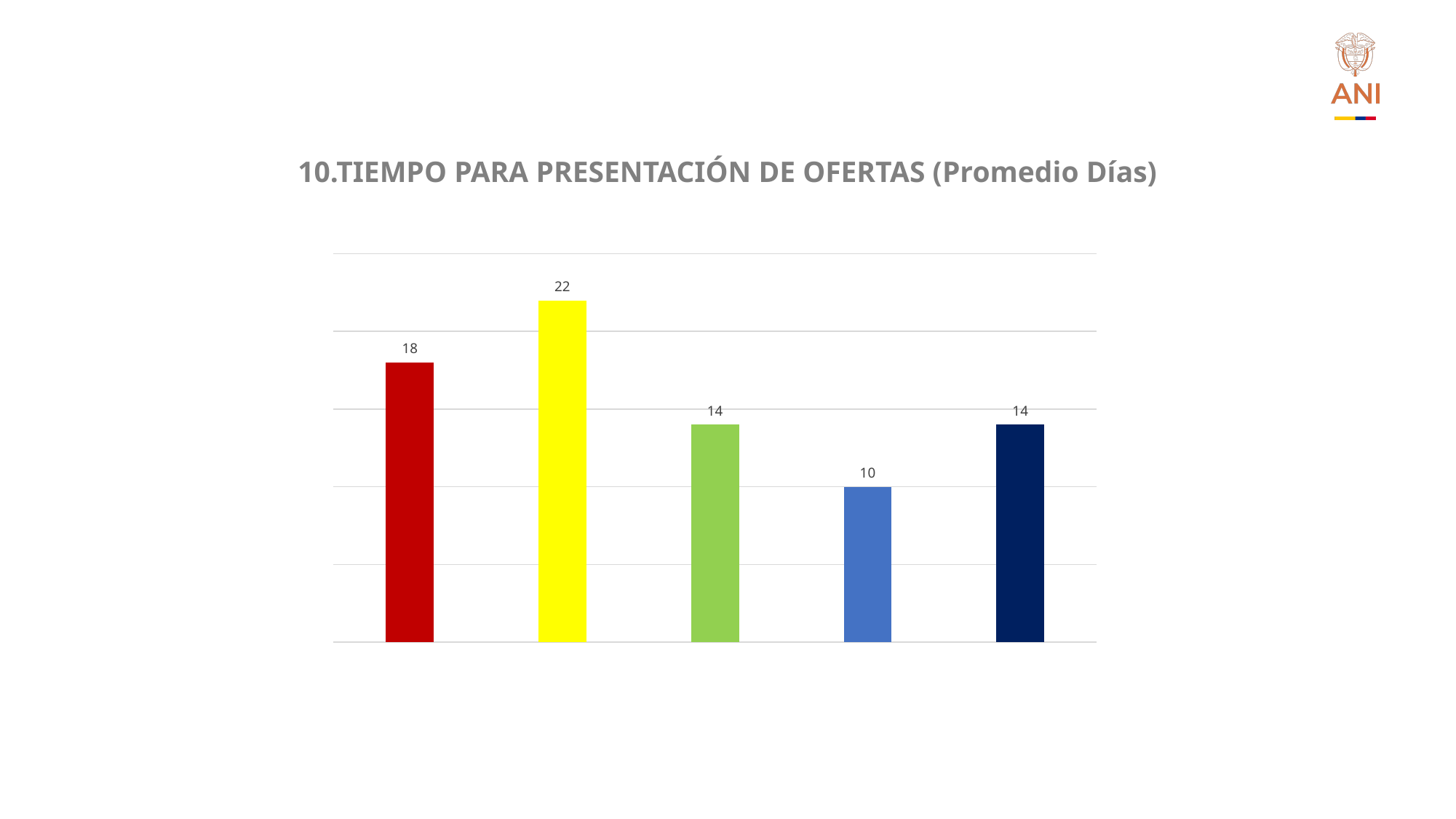
Which bar has the lowest value? the light blue bar (fourth from left) Which bar has the highest value? the yellow bar (second from left) What is the value of the last (dark navy) bar on the right? 14 What is the value of the first (red) bar from the left? 18 What is the value of the light blue bar? 10 What is the title of the chart? 10.TIEMPO PARA PRESENTACIÓN DE OFERTAS (Promedio Días) Which is larger, the red bar or the green bar? the red bar What is the value of the green bar? 14 What type of chart is shown on the slide? bar chart How many bars are plotted in the chart? 5 What is the value of the yellow bar? 22 What is the difference between the yellow bar and the light blue bar? 12